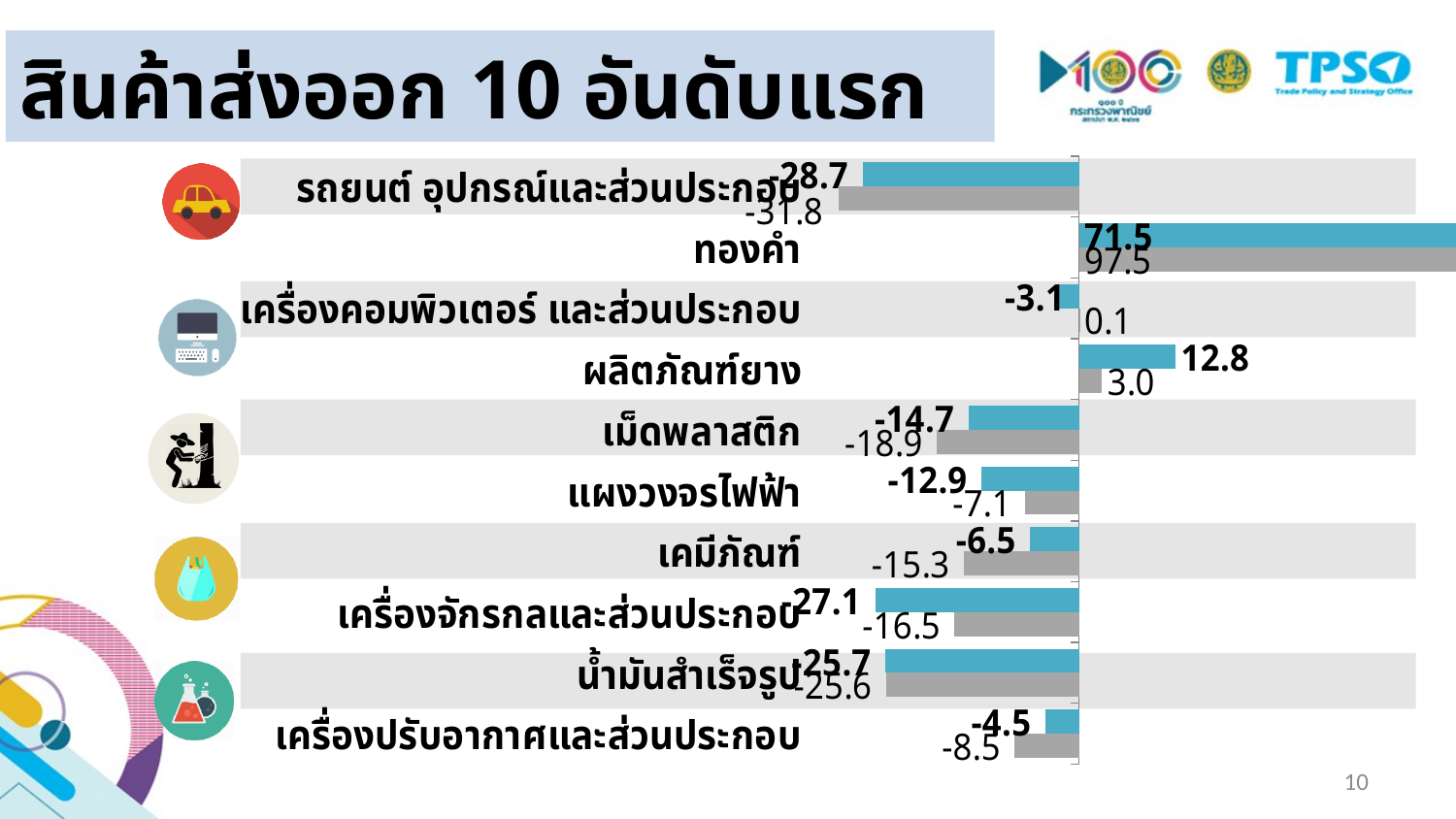
How many product categories are plotted in the chart? 10 Which is larger for แผงวงจรไฟฟ้า, the blue bar value or the gray bar value? gray bar value (-7.1) What is the difference between the blue bar value and the gray bar value for ผลิตภัณฑ์ยาง? 9.8 What is the value of the gray bar for ทองคำ? 97.5 What is the difference between the gray bar value and the blue bar value for ทองคำ? 26.0 What is the value of the blue bar for ทองคำ? 71.5 What kind of chart is shown on the slide? bar chart Which category has the highest blue bar value? ทองคำ What is the value of the blue bar for ผลิตภัณฑ์ยาง? 12.8 What is the value of the blue bar for เคมีภัณฑ์? -6.5 What is the title of the slide containing the chart? สินค้าส่งออก 10 อันดับแรก What is the value of the gray bar for เม็ดพลาสติก? -18.9